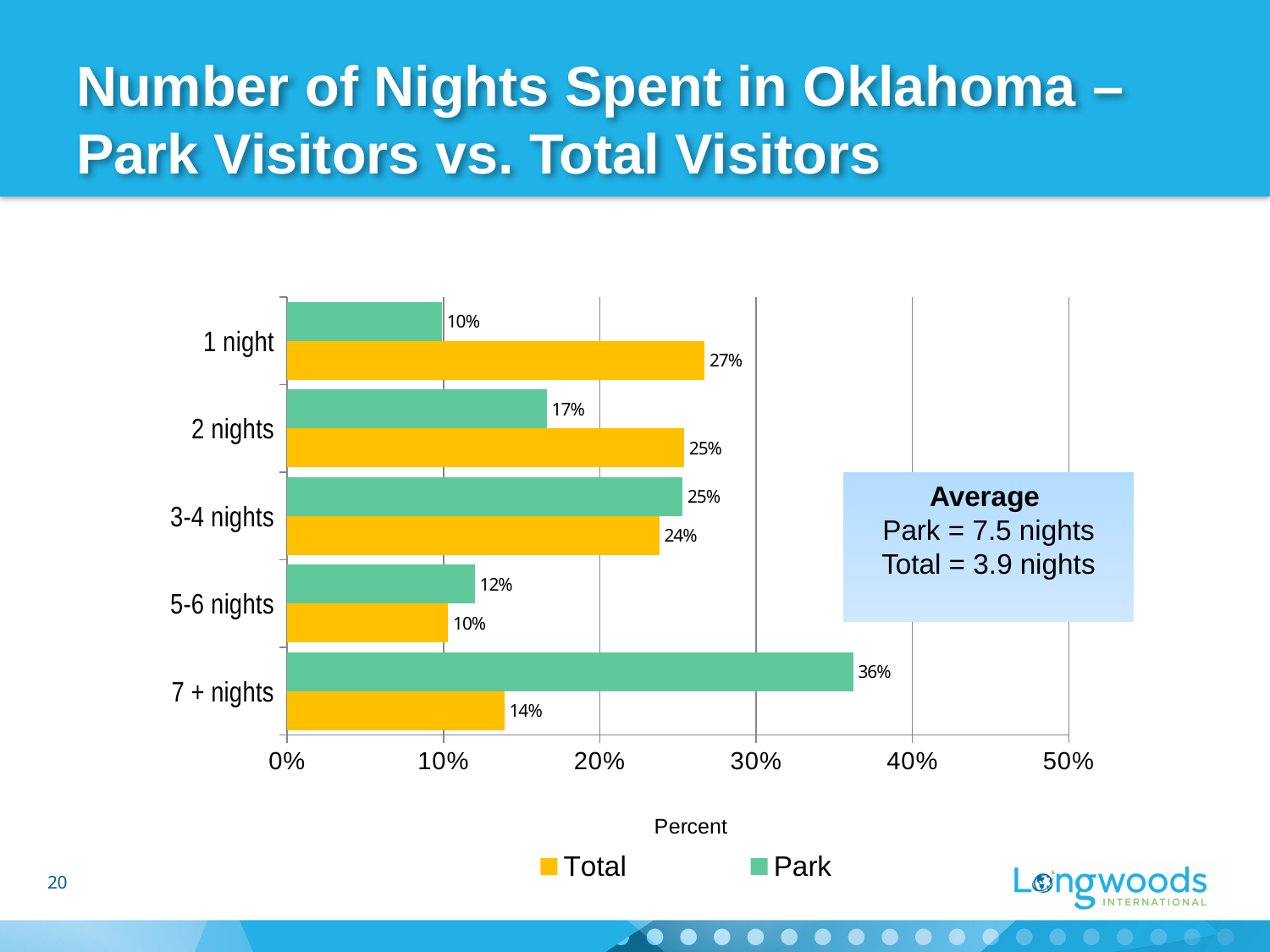
Which category has the highest value for the Park series? 7 + nights For 1 night, which series has the larger value, Total or Park? Total What kind of chart is shown on the slide? Bar chart What percentage of Total visitors spent 1 night in Oklahoma? 27% How many night categories are shown on the chart? 5 What is the difference between the Park and Total values for 7 + nights? 22% Which category has the lowest value for the Total series? 5-6 nights What percentage of Park visitors spent 7 + nights in Oklahoma? 36% How many series does the legend list? 2 What is the Park value for 2 nights? 17% According to the text box on the chart, what is the average number of nights for Park visitors? 7.5 nights Is the Park value for 7 + nights greater or less than 30%? greater